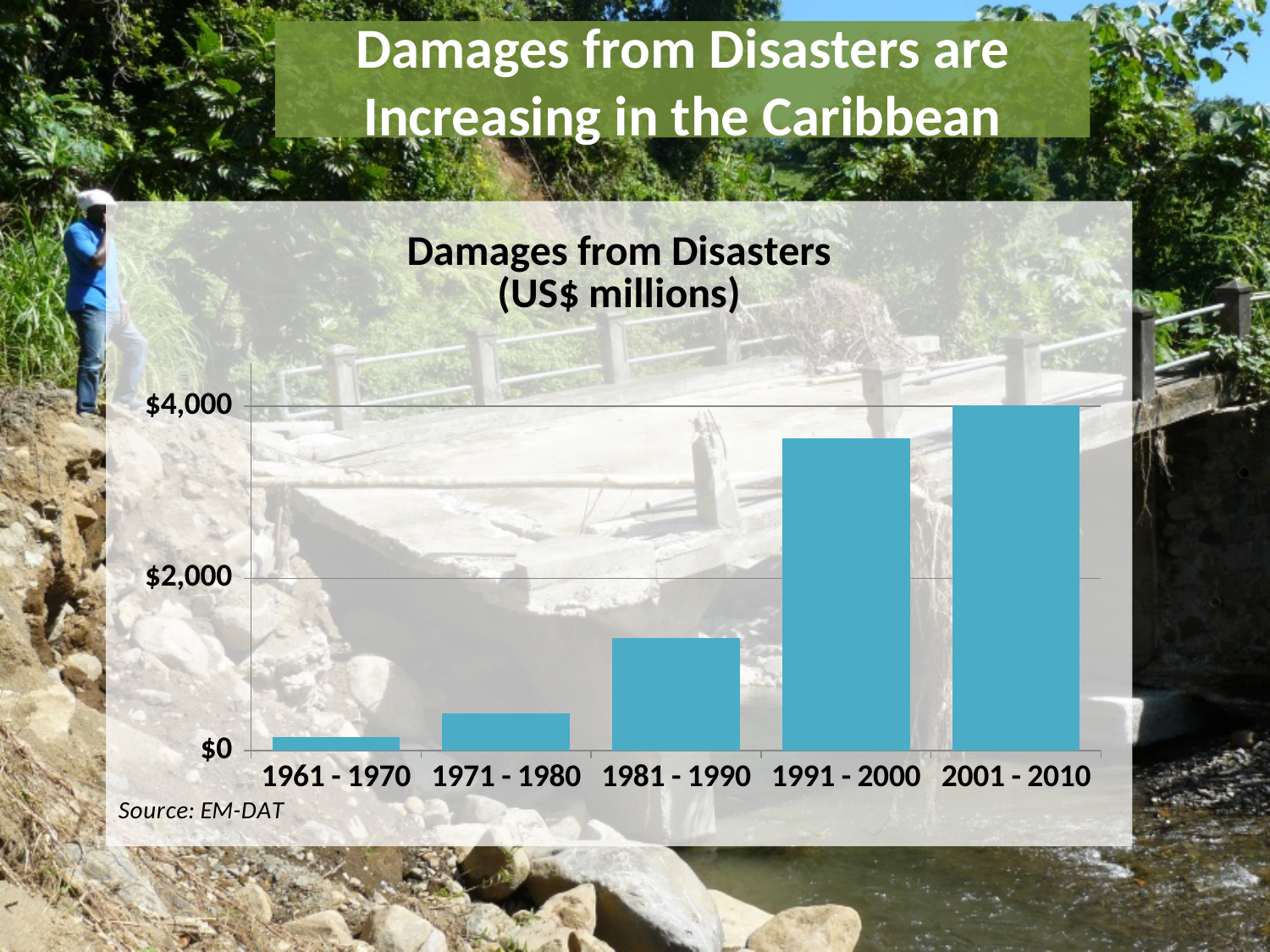
What source is cited for the chart data? EM-DAT Which decade has larger damages from disasters, 1981 - 1990 or 1971 - 1980? 1981 - 1990 What kind of chart is shown on the slide? bar chart What is the title of the chart? Damages from Disasters (US$ millions) Do the damages from disasters rise or fall across the decades from 1961 - 1970 to 2001 - 2010? rise Which decade has the highest damages from disasters in the chart? 2001 - 2010 Is the value for 2001 - 2010 greater or less than $2,000? greater Is the value for 1971 - 1980 greater or less than $2,000? less Is the value for 1991 - 2000 greater or less than $2,000? greater Which decade has the lowest damages from disasters in the chart? 1961 - 1970 How many decade categories are shown on the x axis of the chart? 5